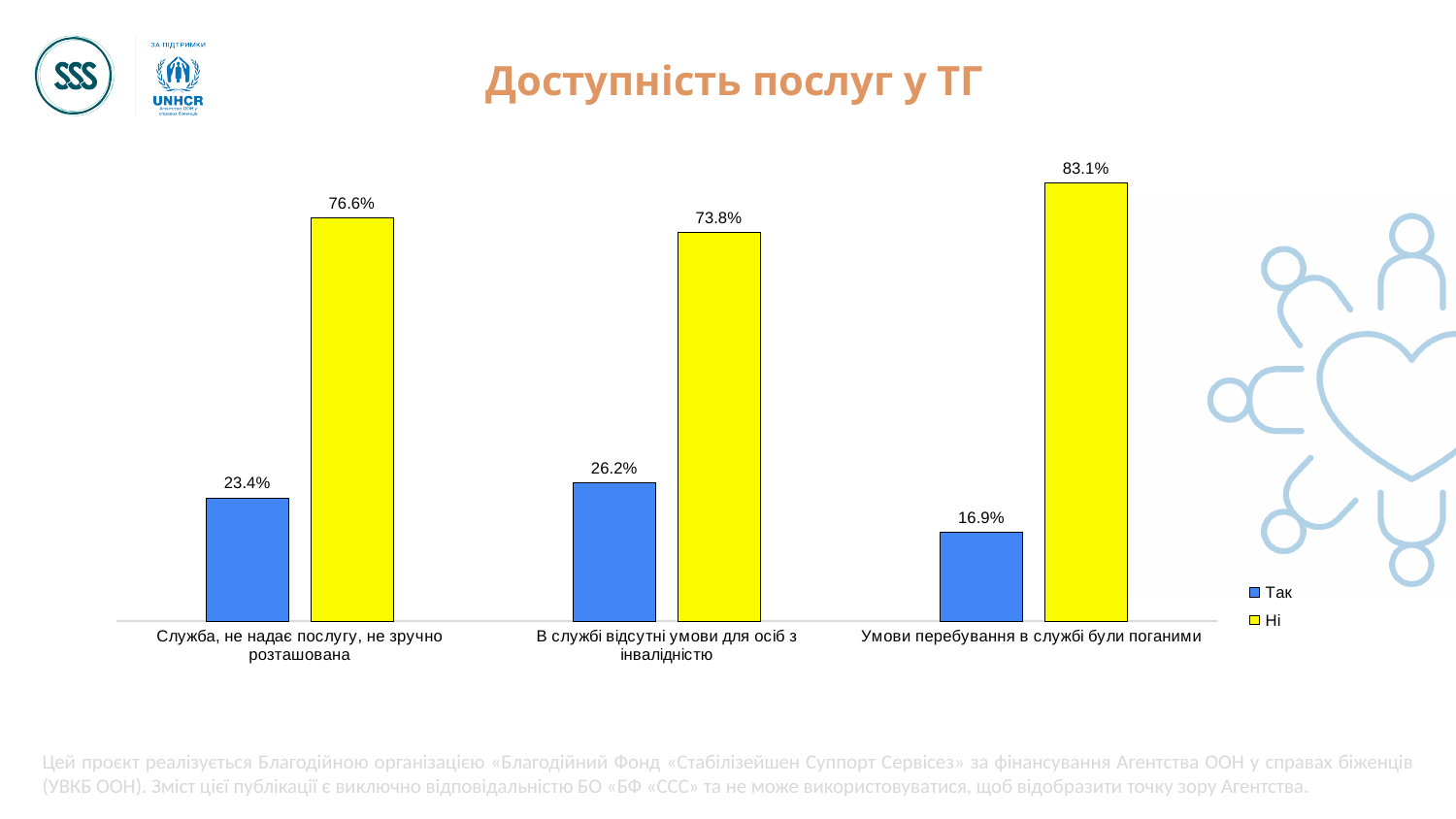
How many categories are shown on the x axis? 3 Which colour represents the "Ні" series in the legend? Yellow Which is larger: the "Так" value for "В службі відсутні умови для осіб з інвалідністю" or the "Так" value for "Служба, не надає послугу, не зручно розташована"? В службі відсутні умови для осіб з інвалідністю What is the value of the "Так" series for "Служба, не надає послугу, не зручно розташована"? 23.4% What is the title of the chart on the slide? Доступність послуг у ТГ What is the difference between the "Ні" and "Так" values for "Служба, не надає послугу, не зручно розташована"? 53.2% Which category has the highest "Ні" value? Умови перебування в службі були поганими What is the value of the "Так" series for "Умови перебування в службі були поганими"? 16.9% How many series does the legend list? 2 What kind of chart is shown on the slide? Bar chart Which category has the lowest "Так" value? Умови перебування в службі були поганими What is the value of the "Ні" series for "В службі відсутні умови для осіб з інвалідністю"? 73.8%